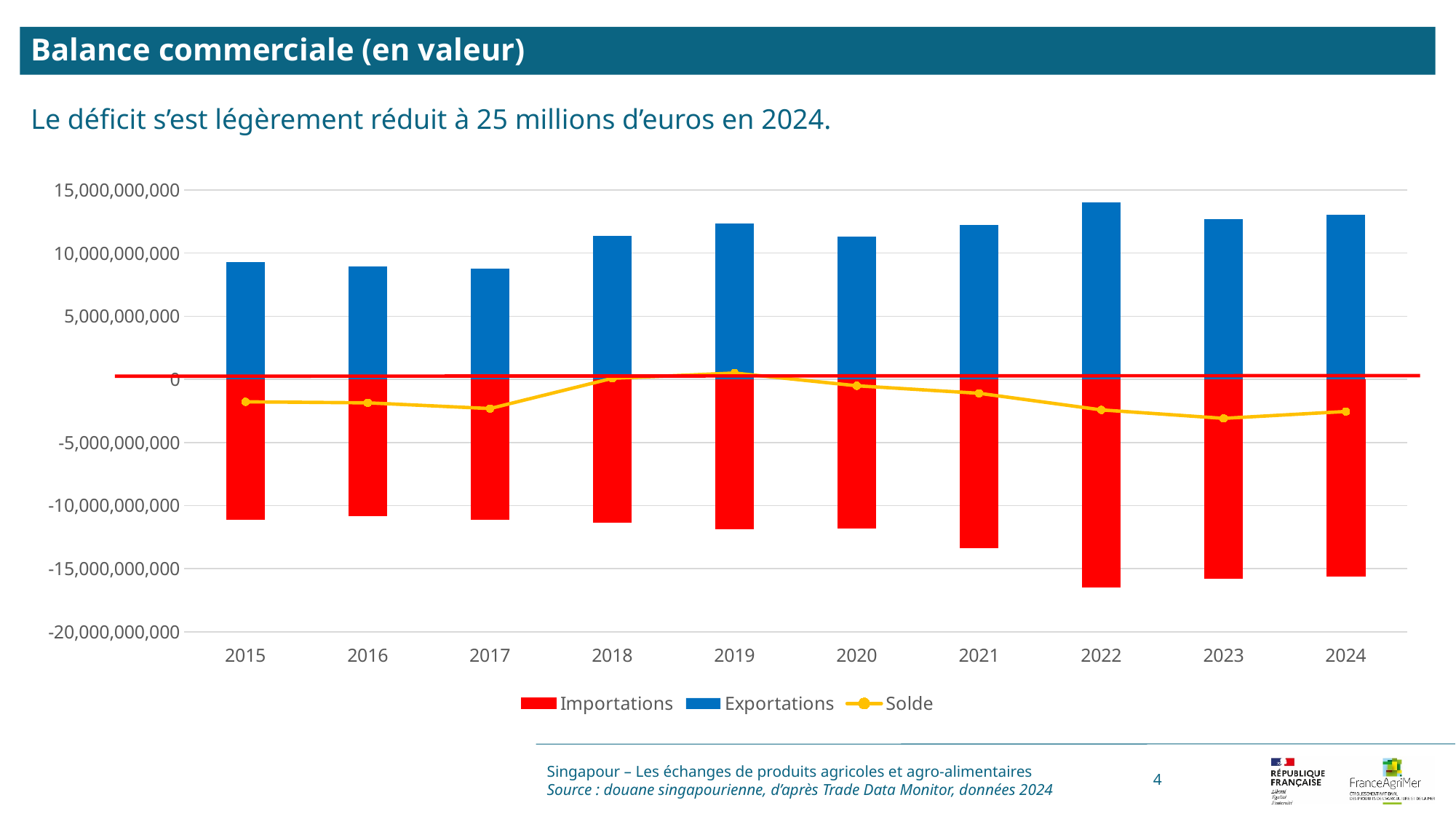
How many series does the chart legend list? 3 Is the Exportations value for 2022 greater or less than 10,000,000,000? greater In which year is the Solde line at its highest point? 2019 Which series are listed in the chart legend? Importations, Exportations, Solde Is the Exportations value for 2015 greater or less than 10,000,000,000? less In which year is the Solde line at its lowest point? 2023 What kind of chart is shown on the slide? A bar chart with a line series Which year has the larger Exportations value, 2015 or 2024? 2024 In which year is the Exportations bar the highest? 2022 In which year does the Importations bar reach the lowest (most negative) value? 2022 How many years are shown on the x axis of the chart? 10 Is the Importations value for 2022 greater or less than -15,000,000,000? less